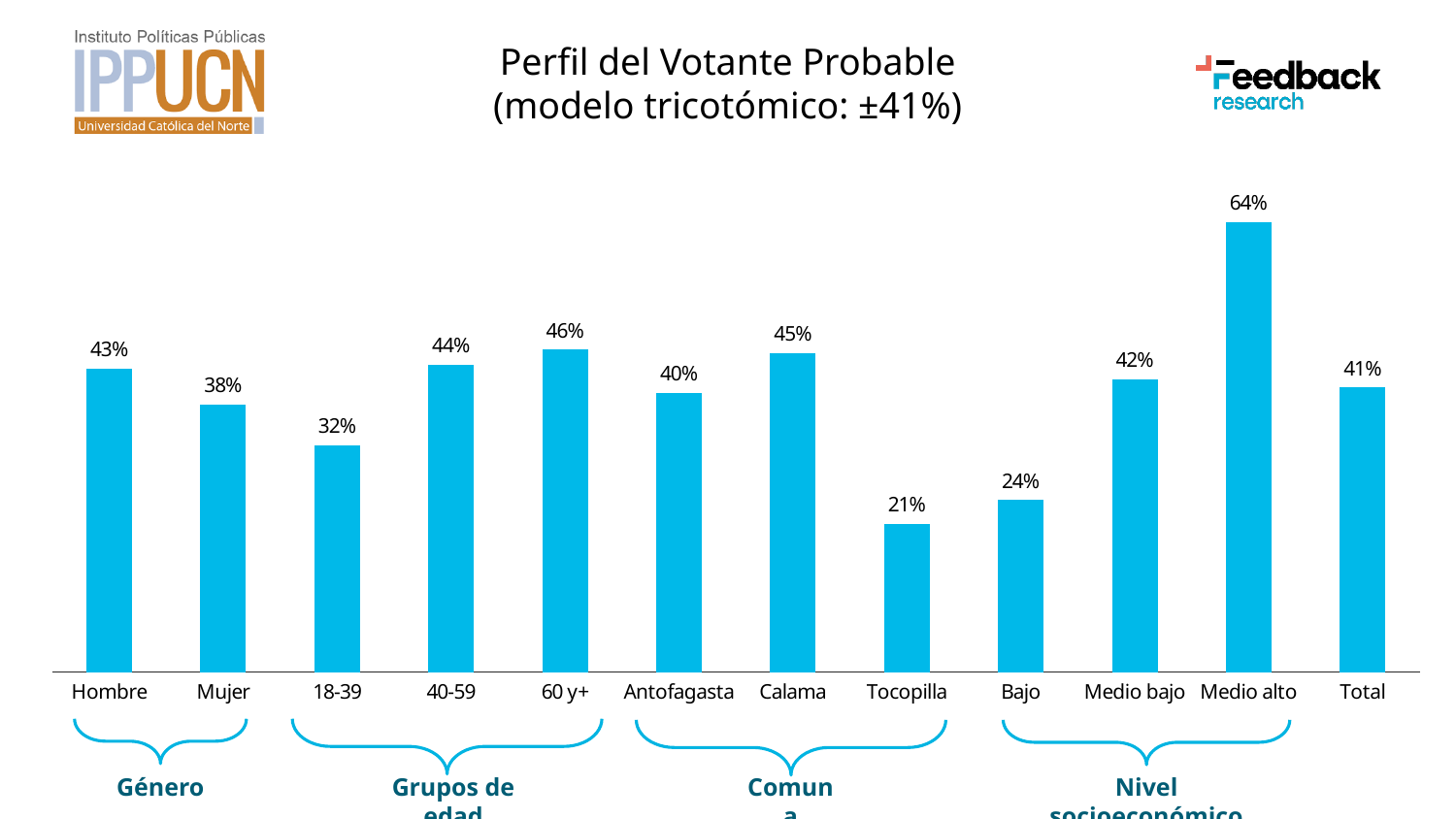
Which category has the lowest value? Tocopilla What is the difference between the values for Medio alto and Bajo? 40% Which category has the highest value? Medio alto What kind of chart is shown on the slide? Bar chart Which is larger, the value for Calama or the value for Antofagasta? Calama Do the values rise or fall across the age groups from 18-39 to 60 y+? Rise What is the value for Total? 41% What is the difference between the values for Hombre and Mujer? 5% What is the value for Medio alto? 64% What is the value for Tocopilla? 21% How many bars are plotted on the chart? 12 What is the value for Hombre? 43%